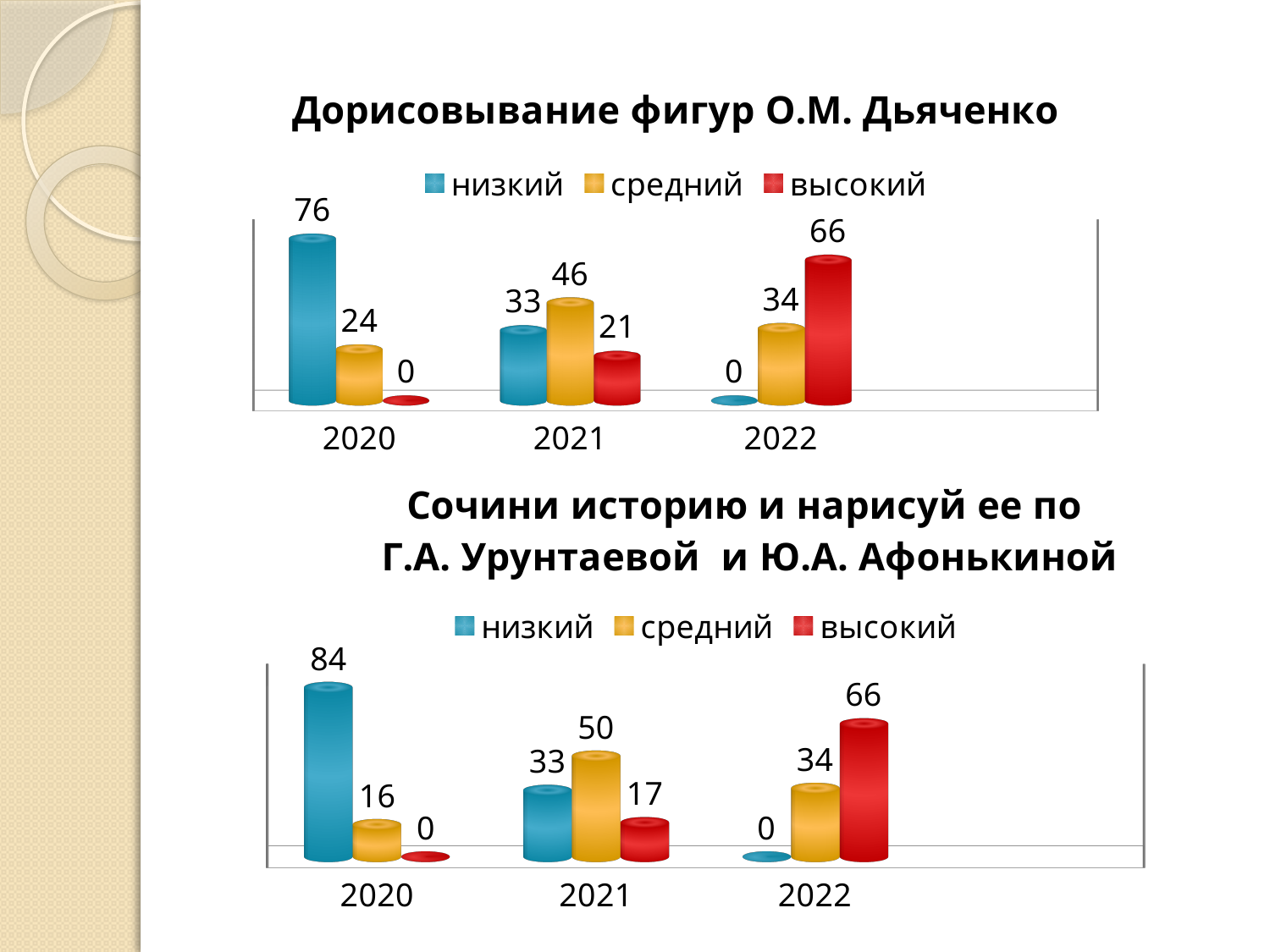
What type of chart is the bottom chart 'Сочини историю и нарисуй ее'? bar chart In the bottom chart 'Сочини историю и нарисуй ее', which is larger in 2021: 'низкий' or 'высокий'? низкий In the top chart 'Дорисовывание фигур О.М. Дьяченко', which year has the highest value for 'средний'? 2021 In the top chart 'Дорисовывание фигур О.М. Дьяченко', what is the value for 'высокий' in 2022? 66 In the bottom chart 'Сочини историю и нарисуй ее', what is the value for 'низкий' in 2020? 84 In the top chart 'Дорисовывание фигур О.М. Дьяченко', does the value for 'низкий' rise or fall from 2020 to 2022? fall In the bottom chart 'Сочини историю и нарисуй ее', what is the value for 'средний' in 2021? 50 In the top chart 'Дорисовывание фигур О.М. Дьяченко', what is the value for 'низкий' in 2020? 76 In the top chart 'Дорисовывание фигур О.М. Дьяченко', what is the difference between 'низкий' in 2020 and 'низкий' in 2021? 43 In the bottom chart 'Сочини историю и нарисуй ее', how many years are shown on the x axis? 3 In the top chart 'Дорисовывание фигур О.М. Дьяченко', how many series does the legend list? 3 In the bottom chart 'Сочини историю и нарисуй ее', what is the difference between 'высокий' in 2022 and 'высокий' in 2021? 49